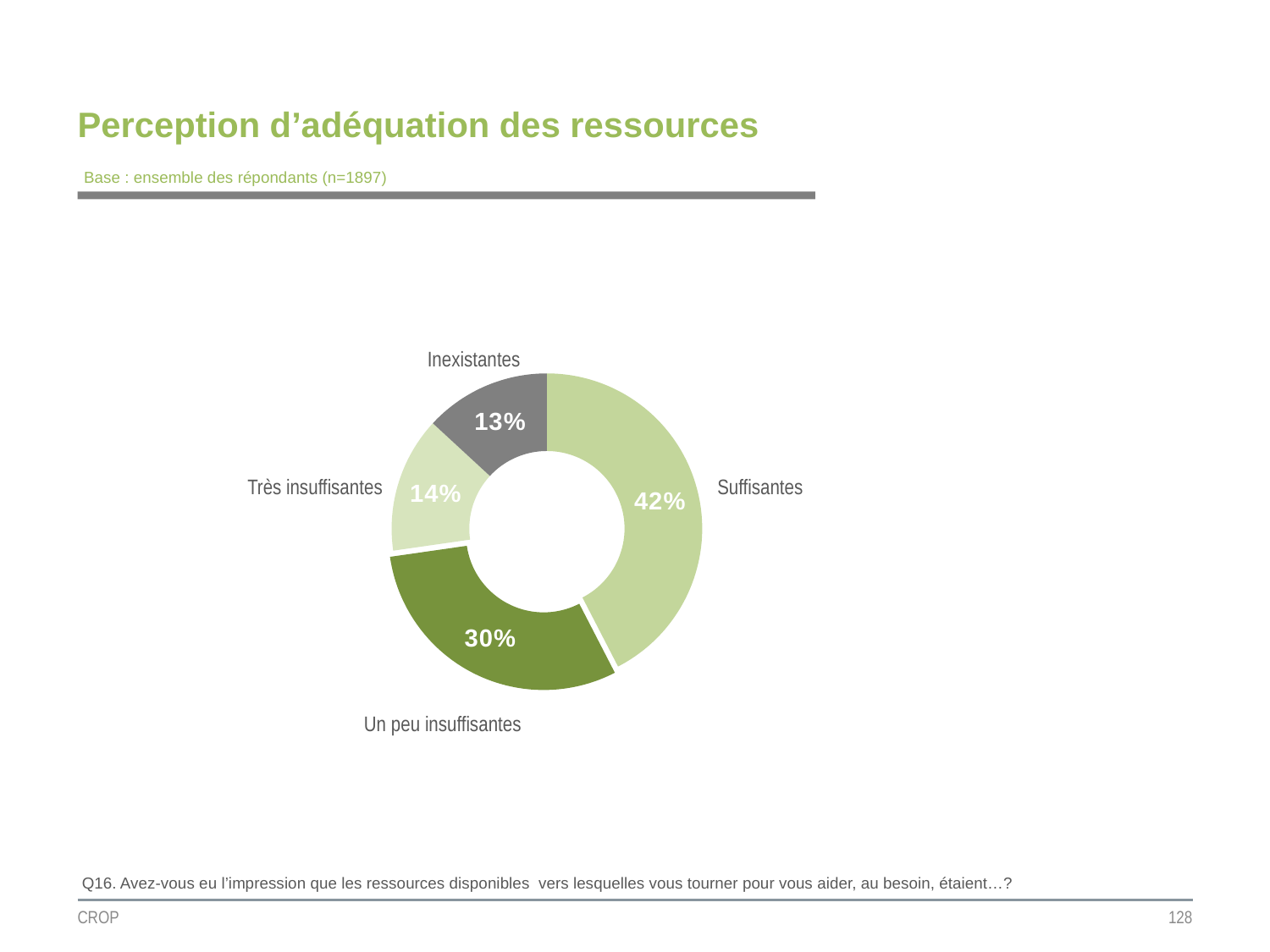
What percentage of respondents said the resources were 'Très insuffisantes'? 14% What kind of chart is shown on the slide? Doughnut (pie) chart How many categories are shown in the chart? 4 Which category has the largest share of the chart? Suffisantes What percentage of respondents said the resources were 'Suffisantes'? 42% Which is larger, the share for 'Un peu insuffisantes' or the share for 'Très insuffisantes'? Un peu insuffisantes What percentage of respondents said the resources were 'Un peu insuffisantes'? 30% What is the combined share of 'Très insuffisantes' and 'Inexistantes'? 27% What is the difference in percentage points between 'Suffisantes' and 'Un peu insuffisantes'? 12 Which category has the smallest share of the chart? Inexistantes What percentage of respondents said the resources were 'Inexistantes'? 13% What is the title of the slide containing the chart? Perception d’adéquation des ressources